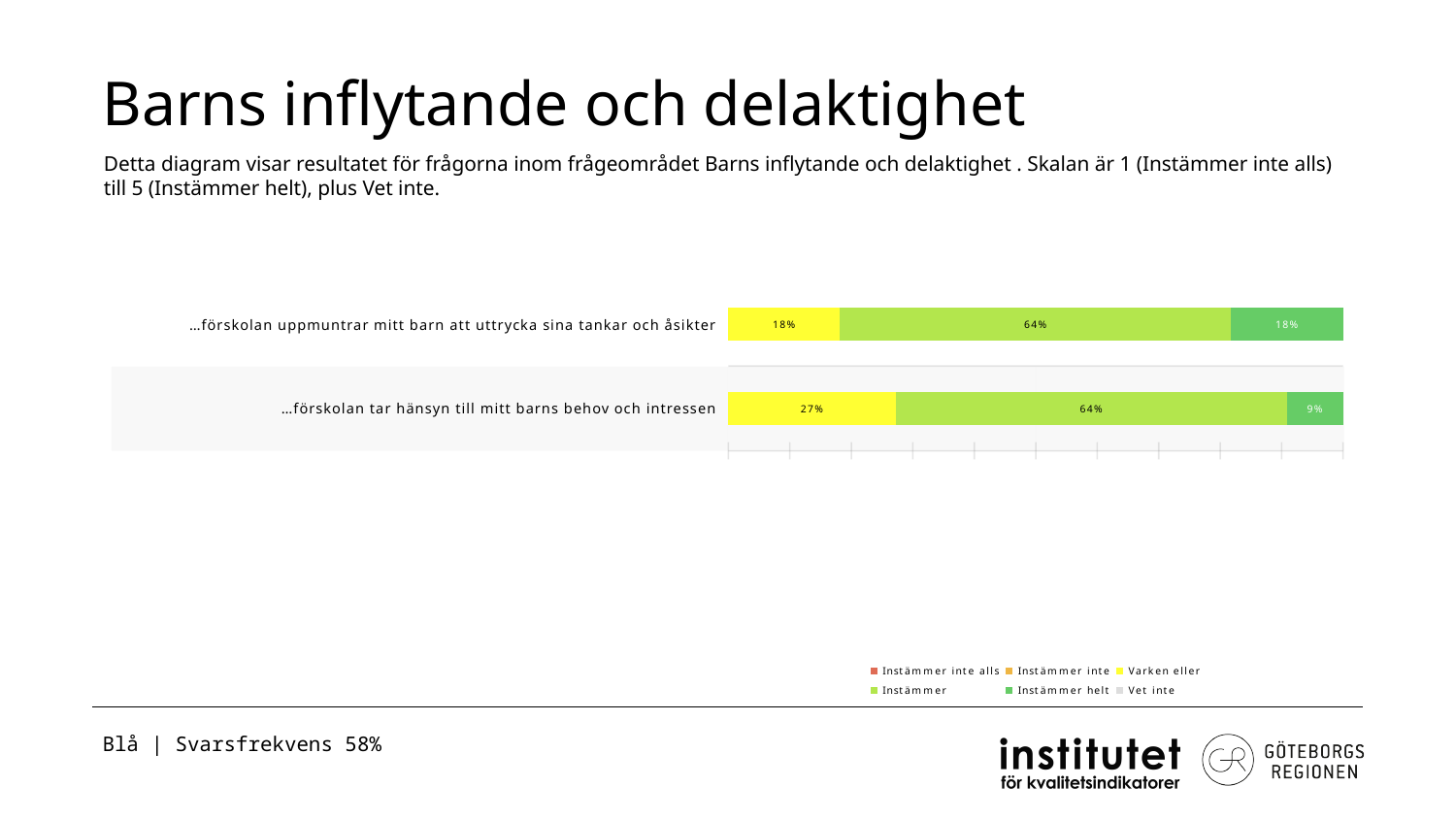
What is the 'Instämmer' value for '…förskolan uppmuntrar mitt barn att uttrycka sina tankar och åsikter'? 64% What kind of chart is shown on the slide? stacked bar chart What is the 'Instämmer helt' value for '…förskolan uppmuntrar mitt barn att uttrycka sina tankar och åsikter'? 18% What is the 'Instämmer helt' value for '…förskolan tar hänsyn till mitt barns behov och intressen'? 9% What is the 'Varken eller' value for '…förskolan tar hänsyn till mitt barns behov och intressen'? 27% Which category has the larger 'Varken eller' share: '…förskolan uppmuntrar mitt barn att uttrycka sina tankar och åsikter' or '…förskolan tar hänsyn till mitt barns behov och intressen'? …förskolan tar hänsyn till mitt barns behov och intressen How many series does the legend list? 6 Which legend entry is shown in yellow? Varken eller How many categories (questions) are plotted in the chart? 2 What is the difference between the 'Varken eller' values of the two categories? 9% What is the total of the labelled segments in the bar for '…förskolan tar hänsyn till mitt barns behov och intressen'? 100% What is the difference between the 'Instämmer helt' values of the two categories? 9%